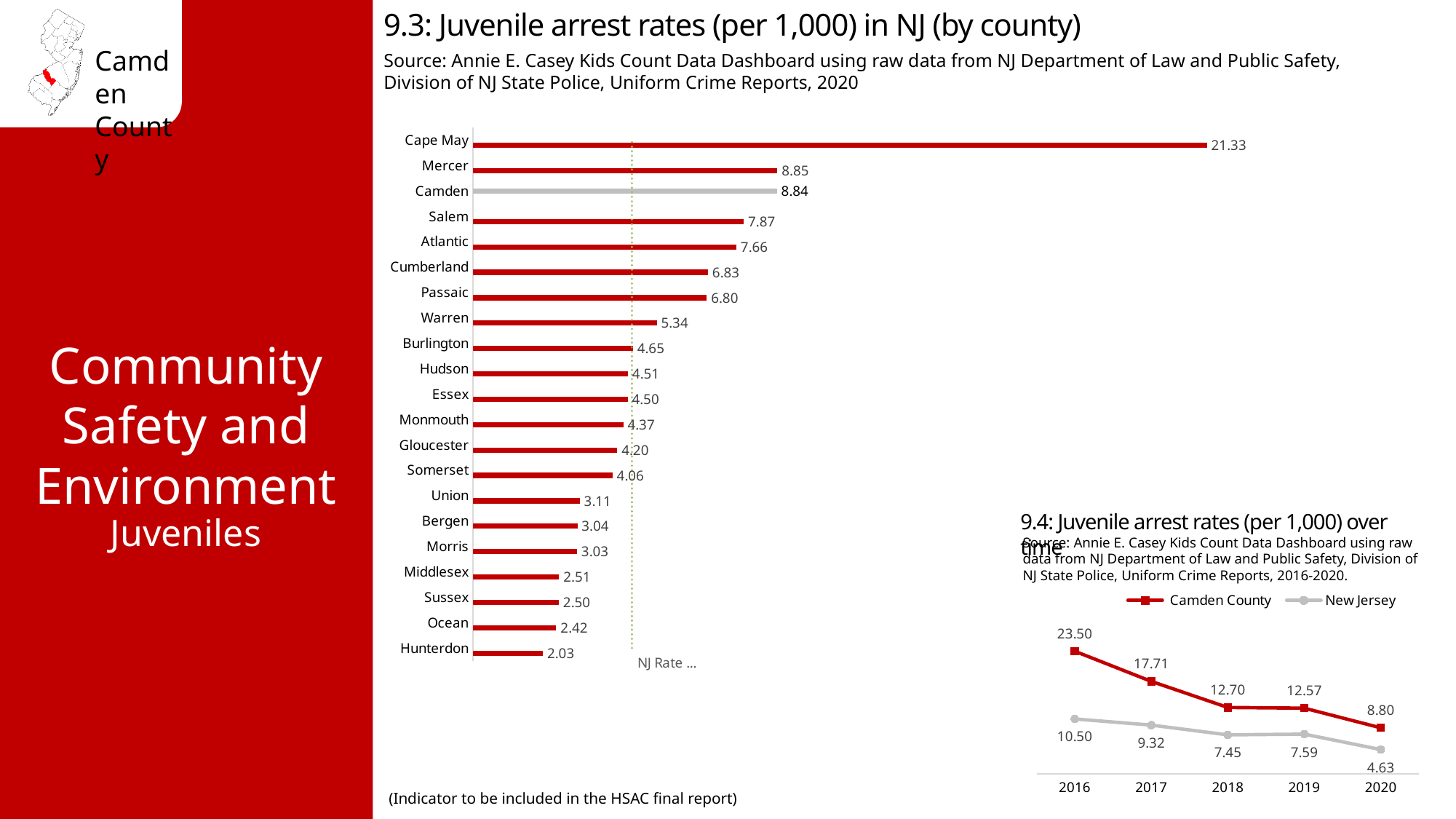
What kind of chart is '9.3: Juvenile arrest rates (per 1,000) in NJ (by county)'? Bar chart In the chart '9.3: Juvenile arrest rates (per 1,000) in NJ (by county)', what is the difference between the values for Cape May and Mercer? 12.48 In the chart '9.4: Juvenile arrest rates (per 1,000) over time', does the Camden County rate rise or fall from 2016 to 2020? Fall In the chart '9.4: Juvenile arrest rates (per 1,000) over time', what is the difference between the Camden County and New Jersey values in 2016? 13.00 In the chart '9.4: Juvenile arrest rates (per 1,000) over time', what is the Camden County value for 2018? 12.70 In the chart '9.3: Juvenile arrest rates (per 1,000) in NJ (by county)', which county has the lowest rate? Hunterdon In the chart '9.4: Juvenile arrest rates (per 1,000) over time', what is the New Jersey value for 2020? 4.63 In the chart '9.3: Juvenile arrest rates (per 1,000) in NJ (by county)', how many counties are plotted? 21 In the chart '9.3: Juvenile arrest rates (per 1,000) in NJ (by county)', what is the value for Camden? 8.84 In the chart '9.4: Juvenile arrest rates (per 1,000) over time', how many series does the legend list? 2 In the chart '9.3: Juvenile arrest rates (per 1,000) in NJ (by county)', which is larger, the value for Salem or the value for Passaic? Salem In the chart '9.3: Juvenile arrest rates (per 1,000) in NJ (by county)', which county has the highest rate? Cape May